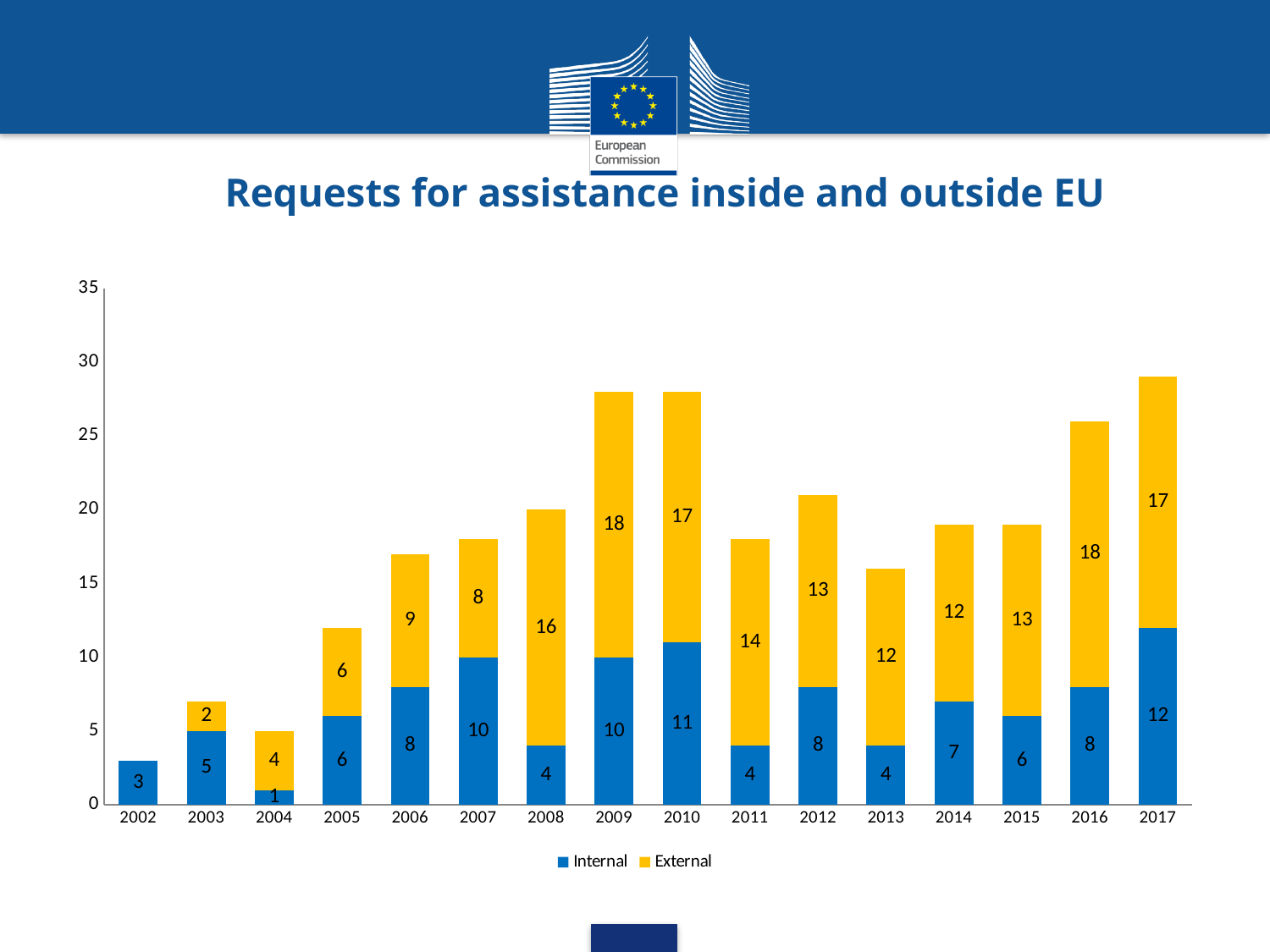
Which is larger, the Internal value for 2007 or the Internal value for 2014? 2007 Which year has the highest Internal value? 2017 How many years are shown on the x axis? 16 What is the External value for 2008? 16 How many series does the legend list? 2 What is the total of the stacked bar for 2005? 12 What kind of chart is shown on the slide? Stacked bar chart What is the Internal value for 2010? 11 What is the total of the stacked bar for 2016? 26 Which year has the lowest Internal value? 2004 What is the difference between the External values for 2009 and 2011? 4 What is the title of the chart? Requests for assistance inside and outside EU